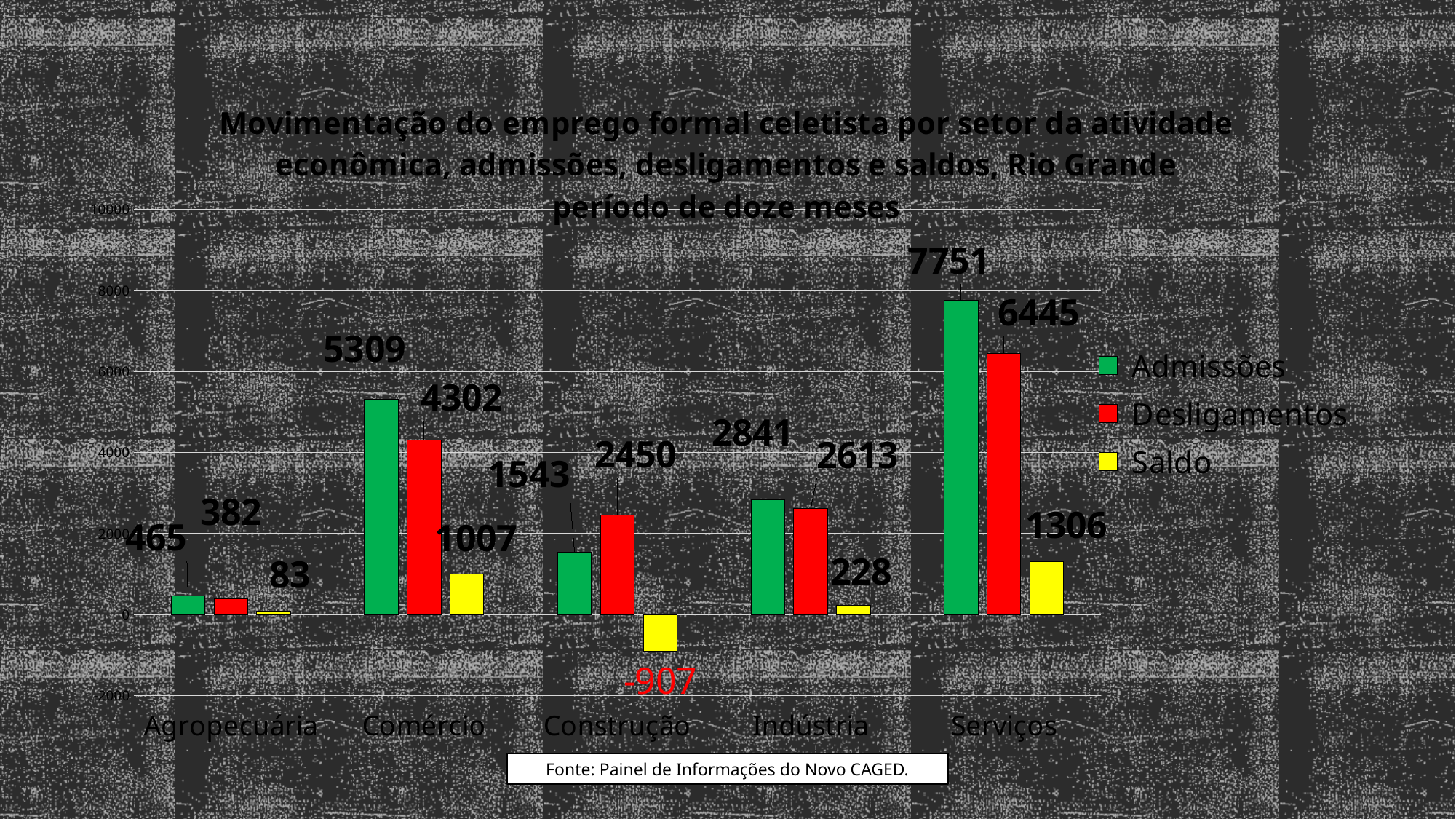
Which sector has the highest Admissões value? Serviços Which sector has the lowest Saldo value? Construção Which is larger for Construção, Admissões or Desligamentos? Desligamentos What kind of chart is shown on the slide? Bar chart How many series does the legend list? 3 What is the value of Desligamentos for Comércio? 4302 What is the difference between Admissões and Desligamentos for Serviços? 1306 What is the value of Admissões for Serviços? 7751 Is the Desligamentos value for Serviços greater or less than 6000? greater How many sectors are shown on the x axis? 5 What is the Saldo value for Construção? -907 What is the value of Admissões for Indústria? 2841